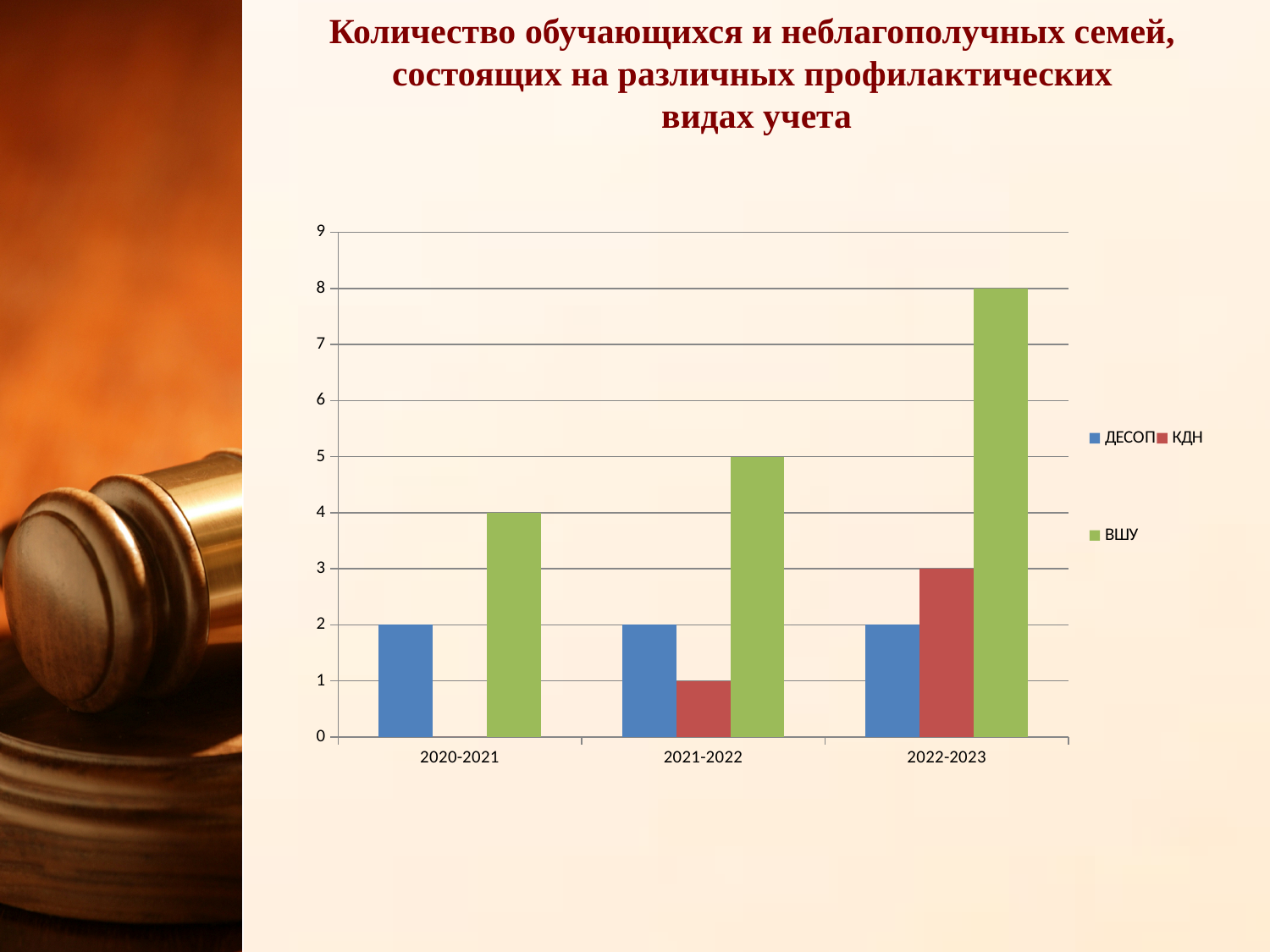
What is the difference between the ВШУ values for 2022-2023 and 2021-2022? 3 What is the value for ВШУ in 2022-2023? 8 How many series does the legend list? 3 How many categories are shown on the x axis? 3 What kind of chart is shown on the slide? bar chart In which year is the value for ВШУ lowest? 2020-2021 What is the value for ДЕСОП in 2021-2022? 2 In which year is the value for ВШУ highest? 2022-2023 Which is larger in 2022-2023, the value for КДН or the value for ДЕСОП? КДН What is the value for ВШУ in 2020-2021? 4 Does the value for ВШУ rise or fall from 2020-2021 to 2022-2023? rise What is the value for КДН in 2021-2022? 1